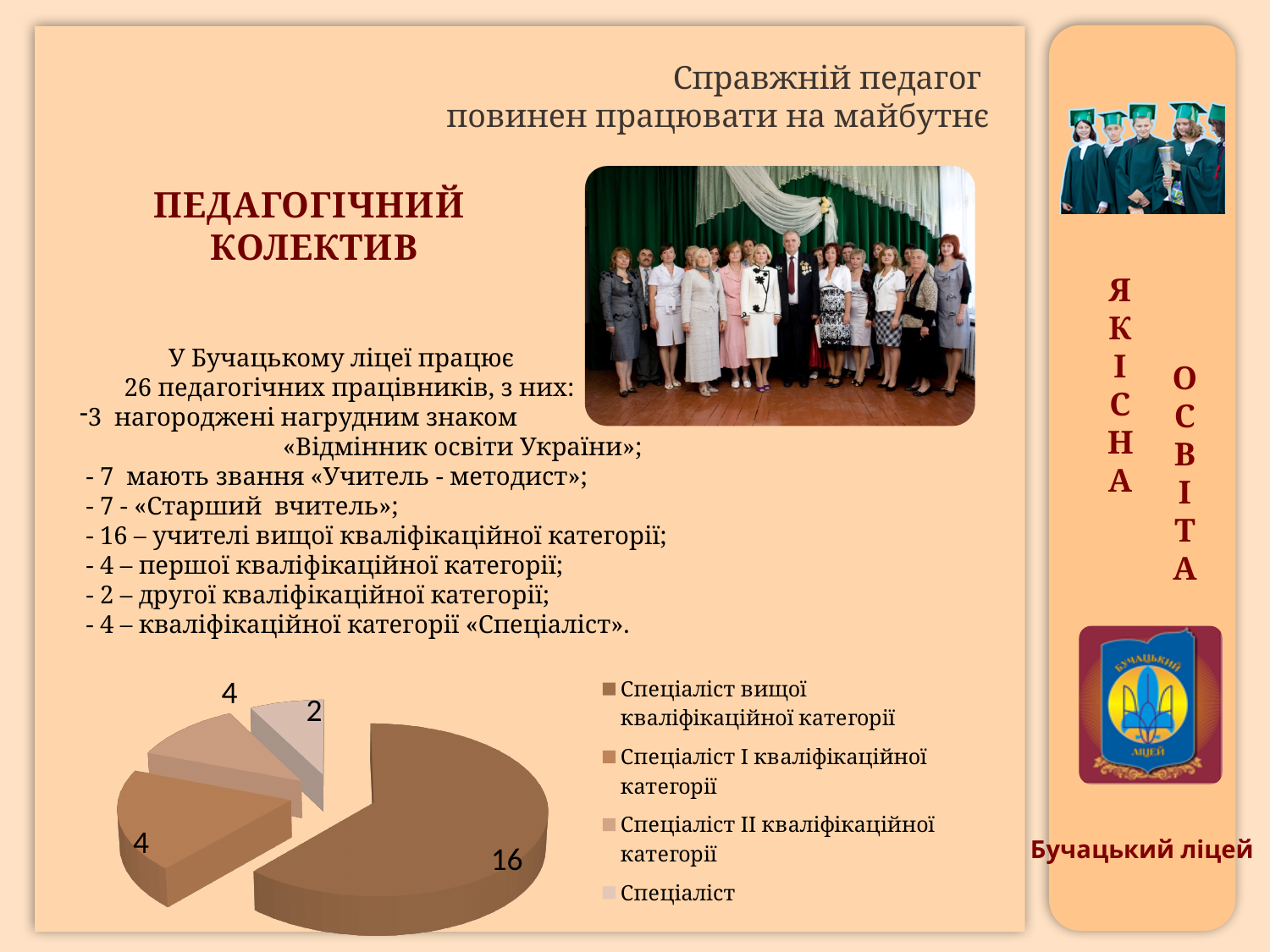
Which category has the largest slice in the pie chart? Спеціаліст вищої кваліфікаційної категорії What is the value for "Спеціаліст вищої кваліфікаційної категорії" in the pie chart? 16 Which legend entry is listed last in the pie chart legend? Спеціаліст Which category has the smallest slice in the pie chart? Спеціаліст What is the total of all the values shown in the pie chart? 26 What kind of chart is shown on the slide? pie chart What is the difference between the value for "Спеціаліст вищої кваліфікаційної категорії" and the value for "Спеціаліст І кваліфікаційної категорії"? 12 How many entries does the pie chart legend list? 4 How many slices does the pie chart have? 4 What is the value for "Спеціаліст І кваліфікаційної категорії" in the pie chart? 4 What is the value for "Спеціаліст ІІ кваліфікаційної категорії" in the pie chart? 4